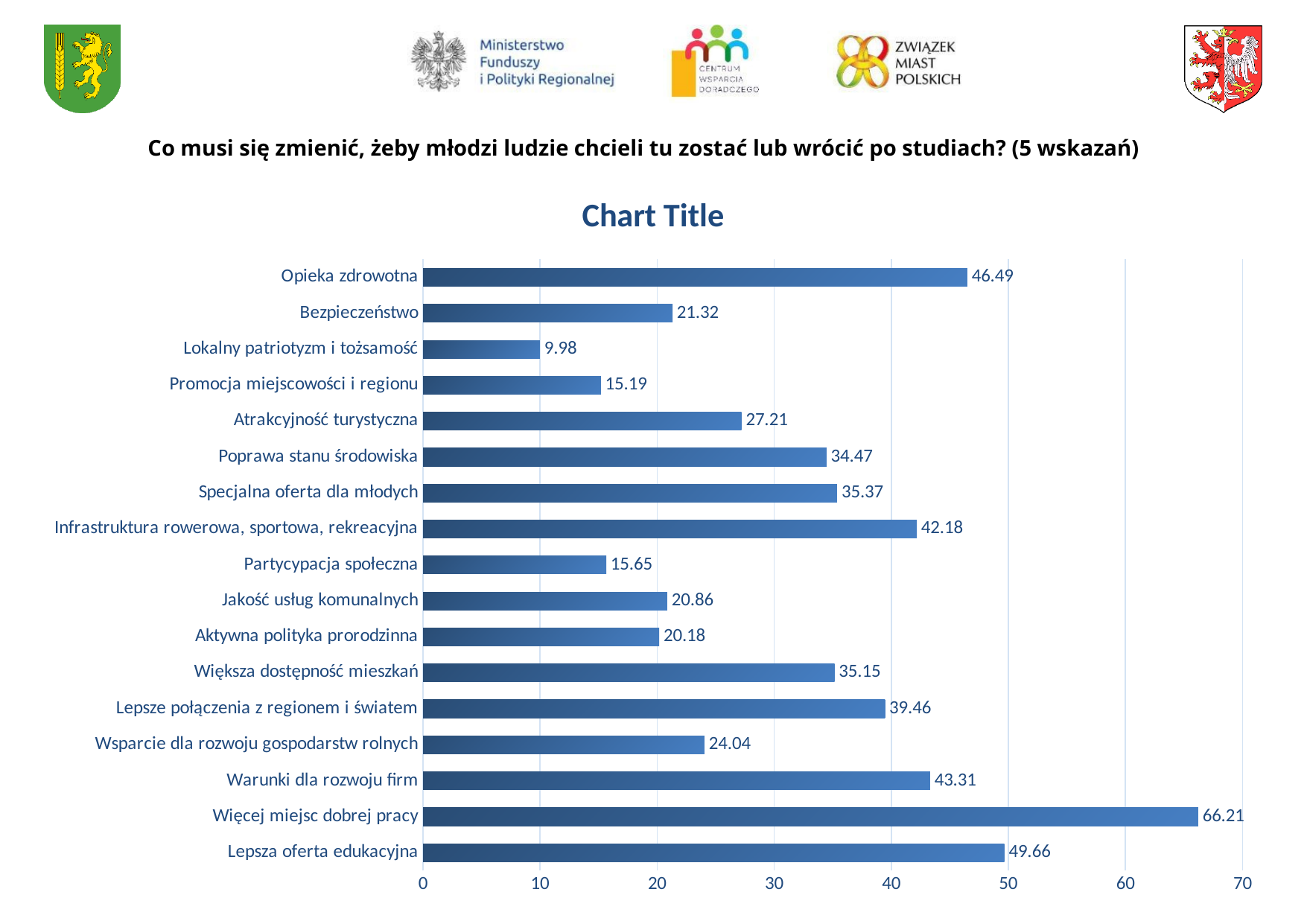
Is the value for Lepsze połączenia z regionem i światem greater or less than 30? greater Which category has the lowest value? Lokalny patriotyzm i tożsamość What kind of chart is shown on the slide? Bar chart What is the difference between the values for Więcej miejsc dobrej pracy and Lepsza oferta edukacyjna? 16.55 Which category has the highest value? Więcej miejsc dobrej pracy What is the value for Partycypacja społeczna? 15.65 How many categories are shown in the chart? 17 What is the title shown above the chart? Chart Title What is the value for Opieka zdrowotna? 46.49 What is the difference between the values for Opieka zdrowotna and Bezpieczeństwo? 25.17 What is the value for Więcej miejsc dobrej pracy? 66.21 Which is larger: the value for Warunki dla rozwoju firm or the value for Infrastruktura rowerowa, sportowa, rekreacyjna? Warunki dla rozwoju firm